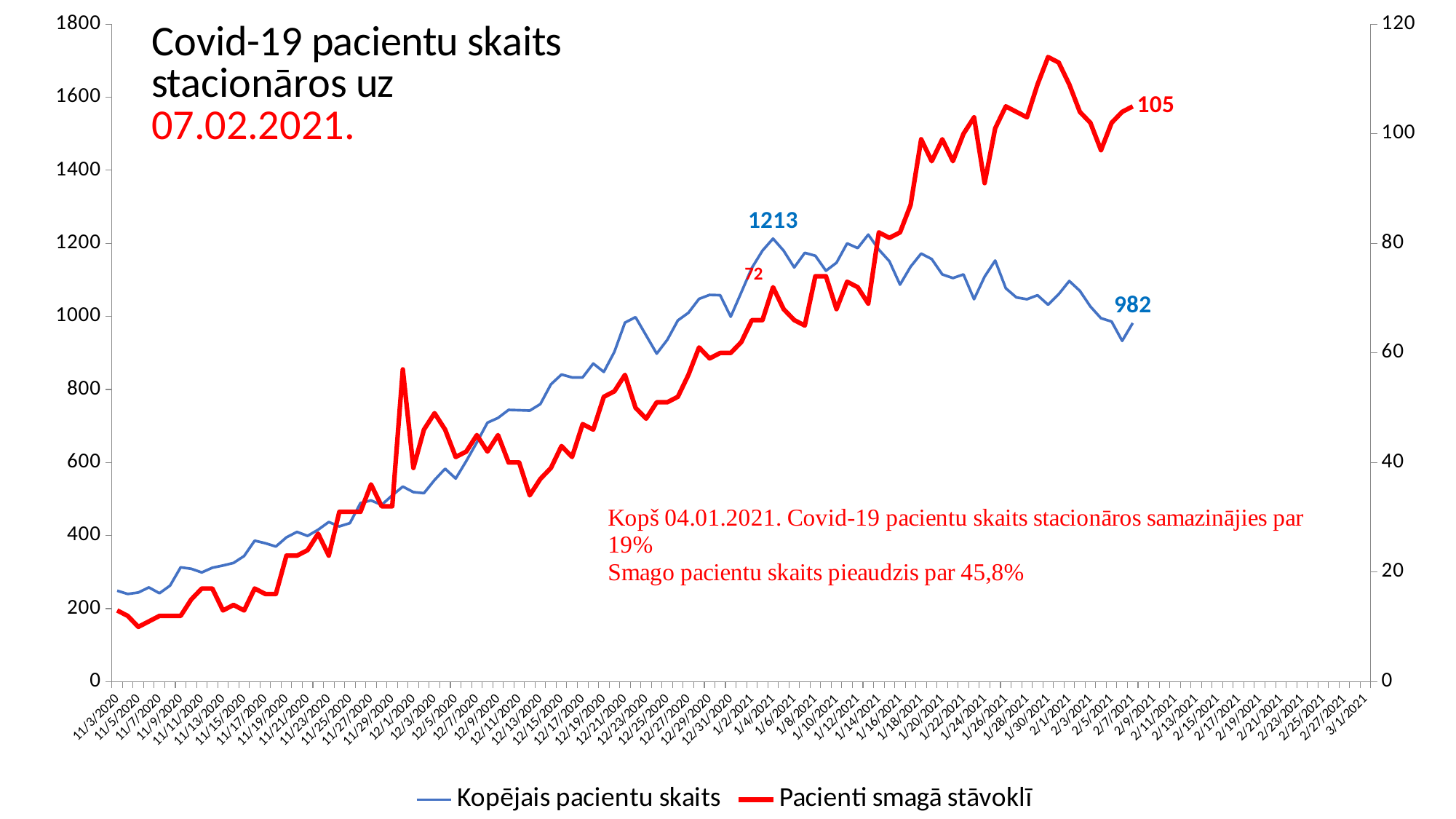
What is the last labelled value of the Kopējais pacientu skaits series? 982 What date is shown in red in the chart title? 07.02.2021. What kind of chart is shown on the slide? line chart How many series does the legend list? 2 What is the difference between the labelled peak of 1213 and the final labelled value of 982 for Kopējais pacientu skaits? 231 Does the Pacienti smagā stāvoklī line generally rise or fall from 11/3/2020 to the end of the series? rise What value is labelled on the Pacienti smagā stāvoklī line around 1/4/2021? 72 What is the last labelled value of the Pacienti smagā stāvoklī series? 105 Is the Kopējais pacientu skaits value at 11/3/2020 greater or less than 400 on the left axis? less What is the peak value labelled on the Kopējais pacientu skaits line around 1/4/2021? 1213 By how much did the labelled Pacienti smagā stāvoklī value rise from 72 to the final labelled value of 105? 33 Does the Kopējais pacientu skaits line rise or fall from its labelled peak of 1213 to the end of the series? fall